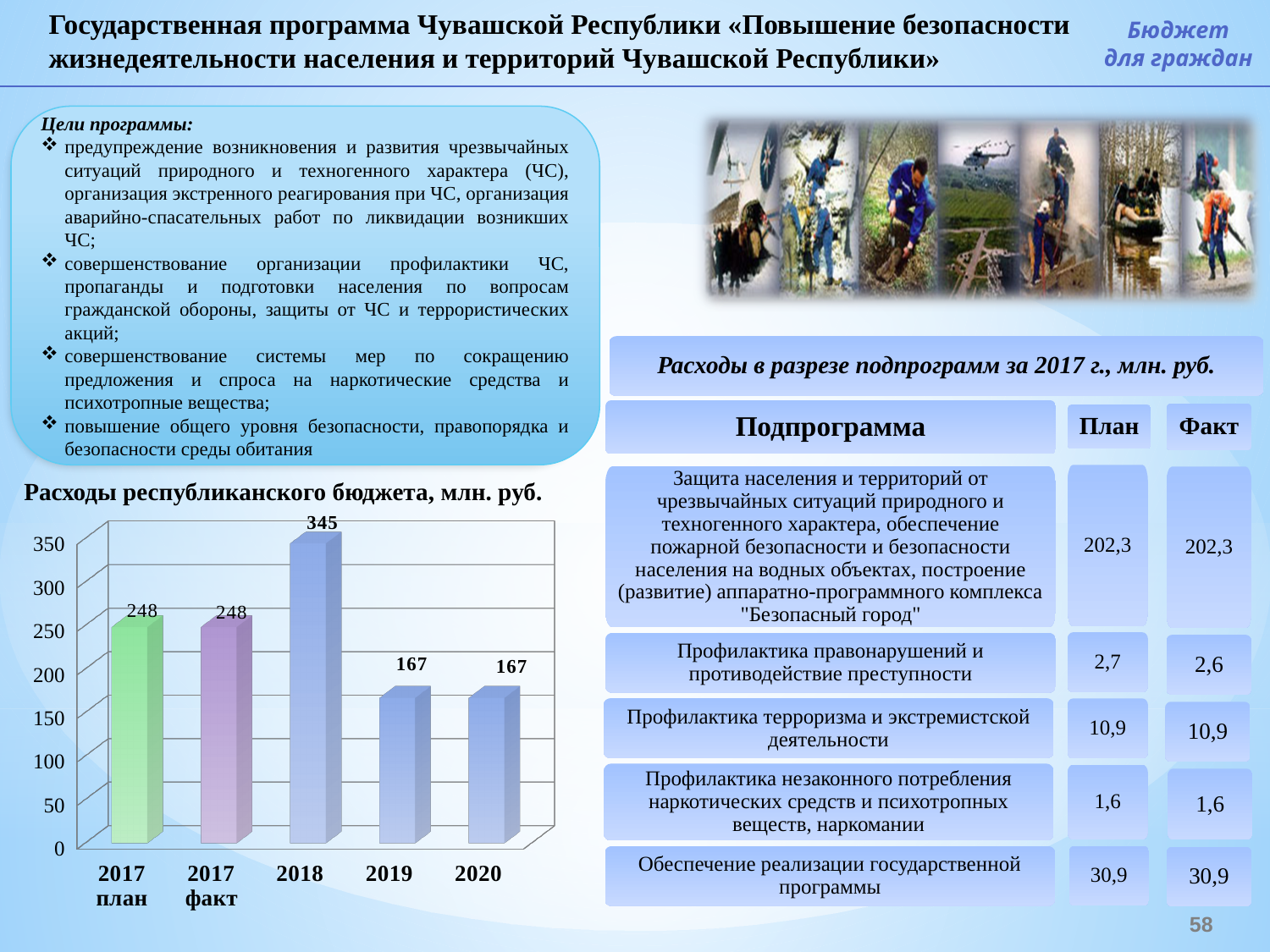
What is the difference between the values for 2018 and 2019 in the chart "Расходы республиканского бюджета, млн. руб."? 178 Do the values fall or rise from 2018 to 2019 in the chart "Расходы республиканского бюджета, млн. руб."? fall What is the difference between the values for 2017 факт and 2020 in the chart "Расходы республиканского бюджета, млн. руб."? 81 How many bars are shown in the chart "Расходы республиканского бюджета, млн. руб."? 5 Which is larger in the chart "Расходы республиканского бюджета, млн. руб.": the value for 2018 or the value for 2017 план? 2018 What kind of chart is "Расходы республиканского бюджета, млн. руб."? bar chart Is the value for 2018 in the chart "Расходы республиканского бюджета, млн. руб." greater or less than 300? greater What is the value for 2017 план in the chart "Расходы республиканского бюджета, млн. руб."? 248 Which category has the highest value in the chart "Расходы республиканского бюджета, млн. руб."? 2018 Is the value for 2019 in the chart "Расходы республиканского бюджета, млн. руб." greater or less than 200? less What is the value for 2020 in the chart "Расходы республиканского бюджета, млн. руб."? 167 What is the value for 2018 in the chart "Расходы республиканского бюджета, млн. руб."? 345